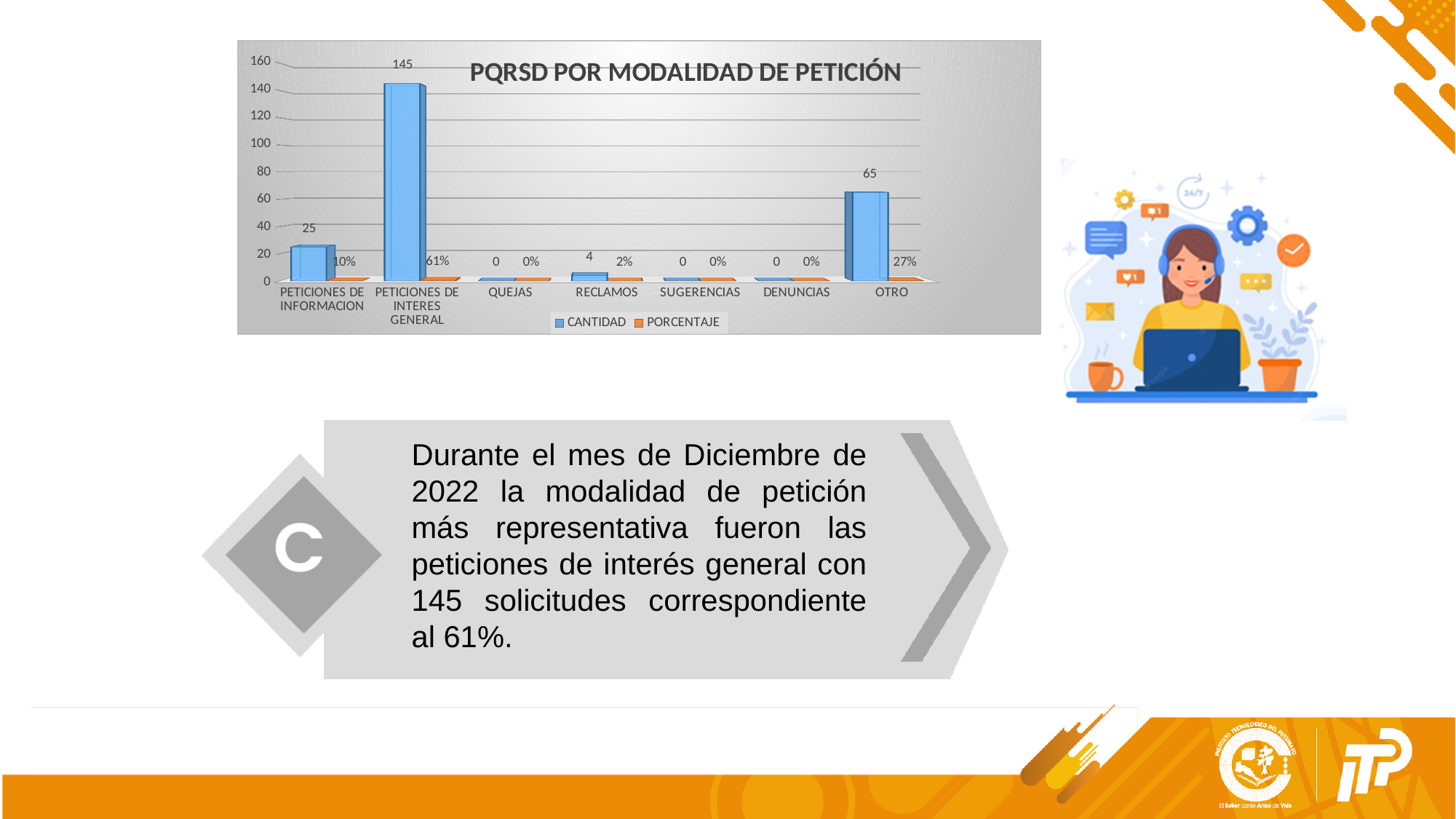
How many categories are shown on the x axis? 7 What is the PORCENTAJE value for OTRO? 27% Which category has the highest CANTIDAD? PETICIONES DE INTERES GENERAL What is the title of the chart? PQRSD POR MODALIDAD DE PETICIÓN What is the CANTIDAD value for RECLAMOS? 4 What is the CANTIDAD value for PETICIONES DE INTERES GENERAL? 145 Which has a larger CANTIDAD, PETICIONES DE INFORMACION or OTRO? OTRO What is the PORCENTAJE value for PETICIONES DE INFORMACION? 10% Is the CANTIDAD value for OTRO greater or less than 60? greater What is the difference in CANTIDAD between PETICIONES DE INTERES GENERAL and OTRO? 80 What kind of chart is shown? bar chart How many series does the legend list? 2